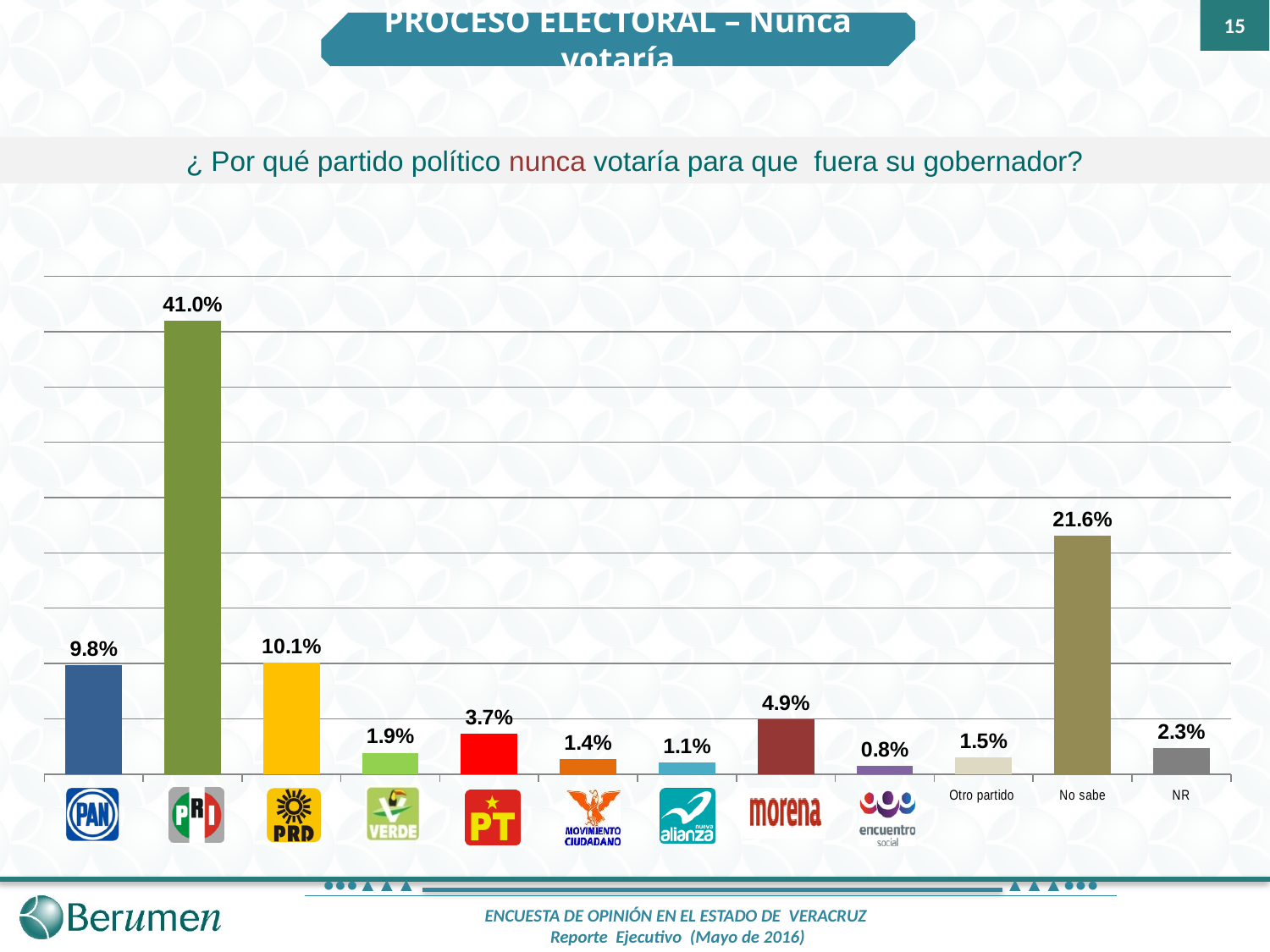
Which has a larger value, PT or Verde? PT Which category has the lowest value in the chart? Encuentro Social How many categories (bars) are shown in the chart? 12 What percentage is shown for Morena? 4.9% Which has a larger value, PAN or PRD? PRD What is the value for Encuentro Social? 0.8% What kind of chart is shown on the slide? Bar chart What is the difference between the values for PRD and PAN? 0.3% What is the difference between the values for PRI and "No sabe"? 19.4% What percentage of respondents said they would never vote for PRI? 41.0% What is the value shown for "No sabe"? 21.6% Which category has the highest value in the chart? PRI